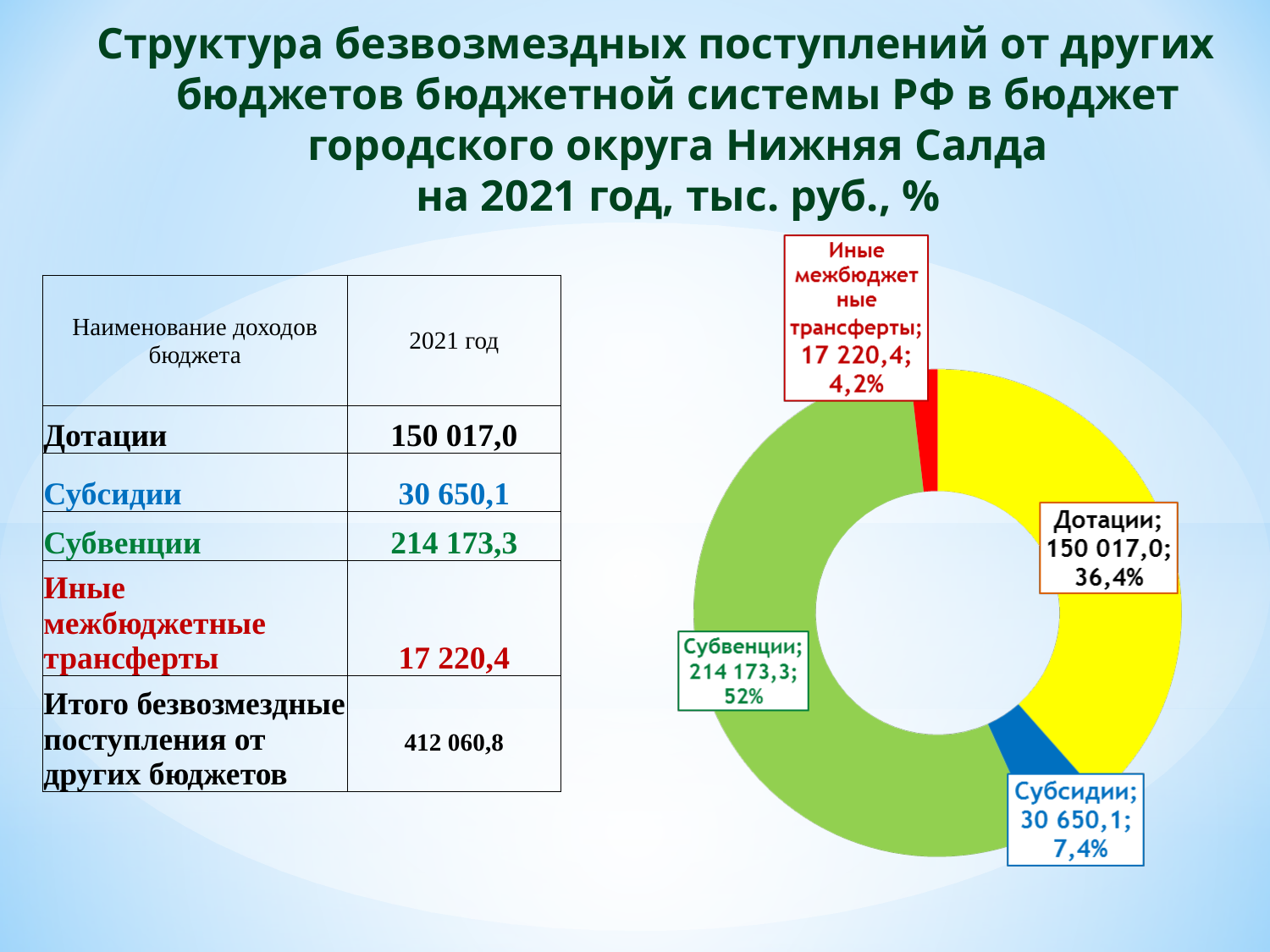
What kind of chart is shown on the slide? Doughnut (ring) chart What share of the chart does Дотации account for? 36,4% What value is shown for Дотации on the chart? 150 017,0 What value is shown for Субсидии on the chart? 30 650,1 What value is shown for Субвенции on the chart? 214 173,3 What value is shown for Иные межбюджетные трансферты on the chart? 17 220,4 Which is larger, the value for Субсидии or the value for Иные межбюджетные трансферты? Субсидии Which category has the largest slice of the chart? Субвенции Which category has the smallest slice of the chart? Иные межбюджетные трансферты What share of the chart does Субвенции account for? 52% How many categories are shown on the chart? 4 What is the difference between the values for Субвенции and Дотации? 64 156,3